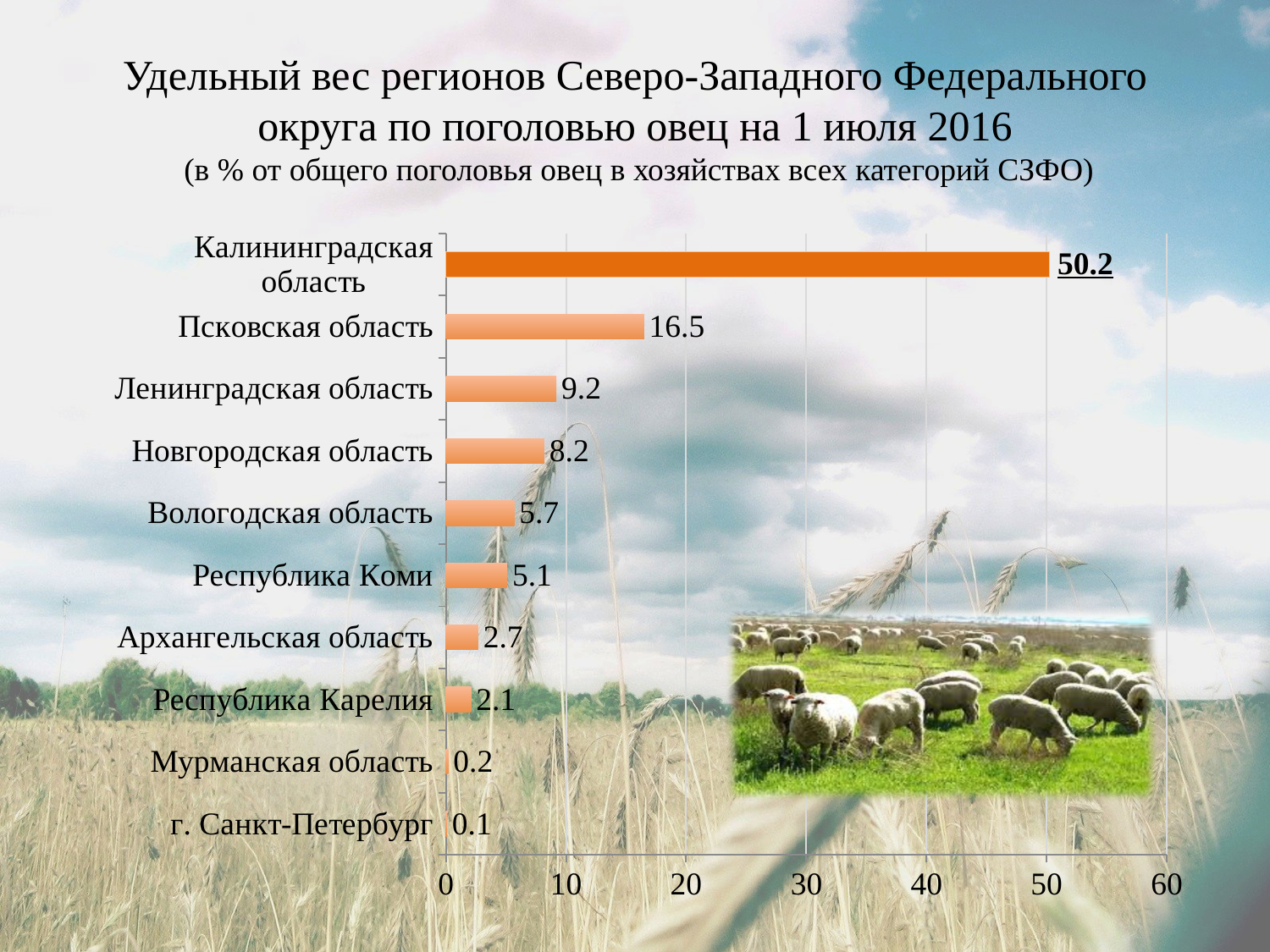
What kind of chart is shown on the slide? bar chart What is the highest value shown on the horizontal axis? 60 Which region has the lowest value? г. Санкт-Петербург What is the difference between the values for Калининградская область and Псковская область? 33.7 What is the value for Калининградская область? 50.2 Which is larger, the value for Вологодская область or the value for Архангельская область? Вологодская область What is the value for Псковская область? 16.5 How many regions are shown in the chart? 10 What is the difference between the values for Ленинградская область and Новгородская область? 1.0 What is the value for Мурманская область? 0.2 What is the value for Республика Коми? 5.1 Which region has the highest value? Калининградская область